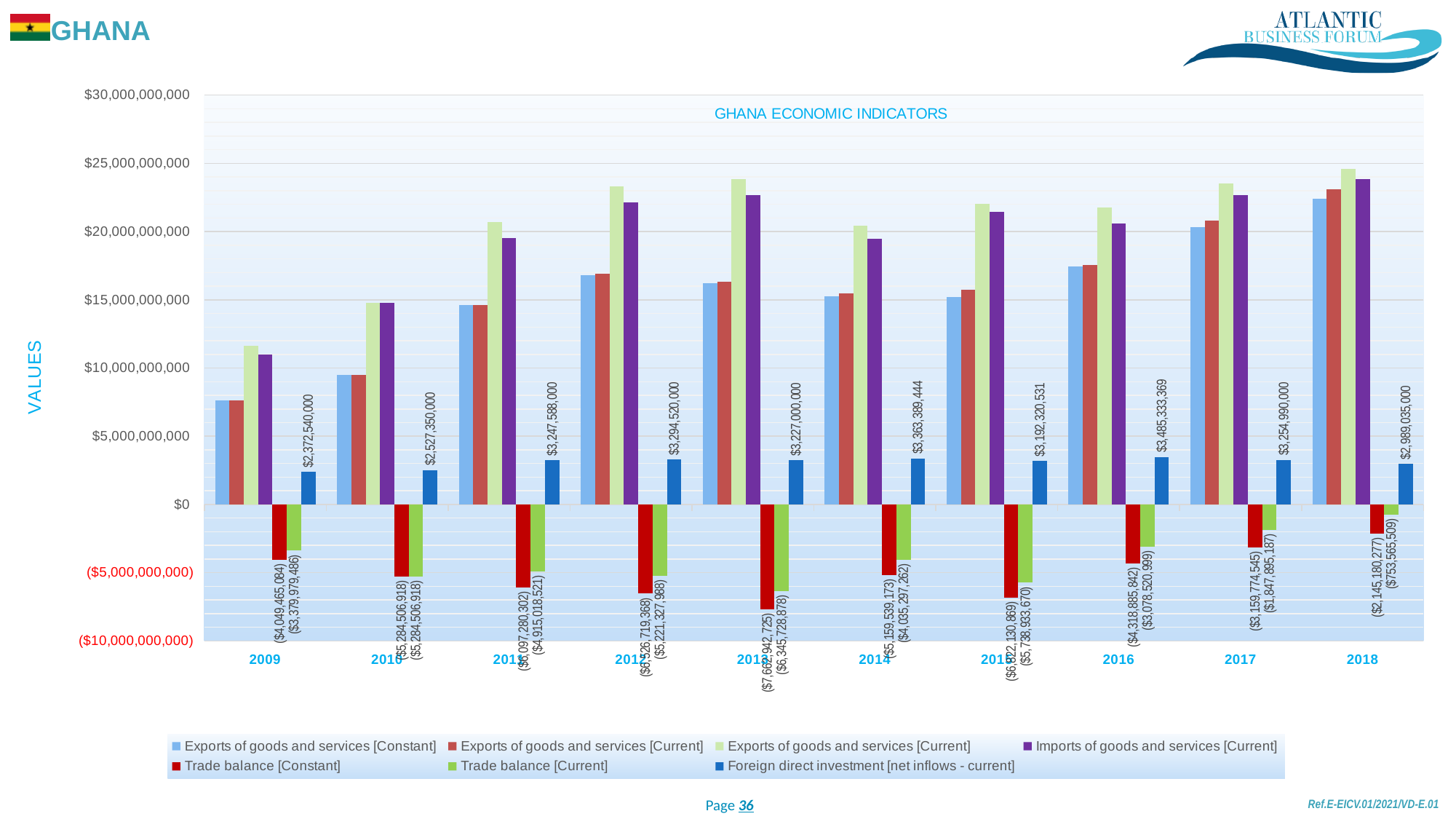
What is the value of Foreign direct investment [net inflows - current] for 2016? $3,485,333,369 How many series does the legend list? 7 What is the value of Trade balance [Constant] for 2013? ($7,662,942,725) In which year is Foreign direct investment [net inflows - current] highest? 2016 In which year is Foreign direct investment [net inflows - current] lowest? 2009 How many years are shown on the x axis? 10 What is the title of the chart? GHANA ECONOMIC INDICATORS What is the value of Trade balance [Current] for 2018? ($753,565,509) Is the value of Imports of goods and services [Current] for 2018 greater or less than $20,000,000,000? greater What kind of chart is shown on the slide? bar chart Is Imports of goods and services [Current] larger in 2013 or in 2014? 2013 What is the difference between Foreign direct investment [net inflows - current] in 2016 and in 2009? $1,112,793,369